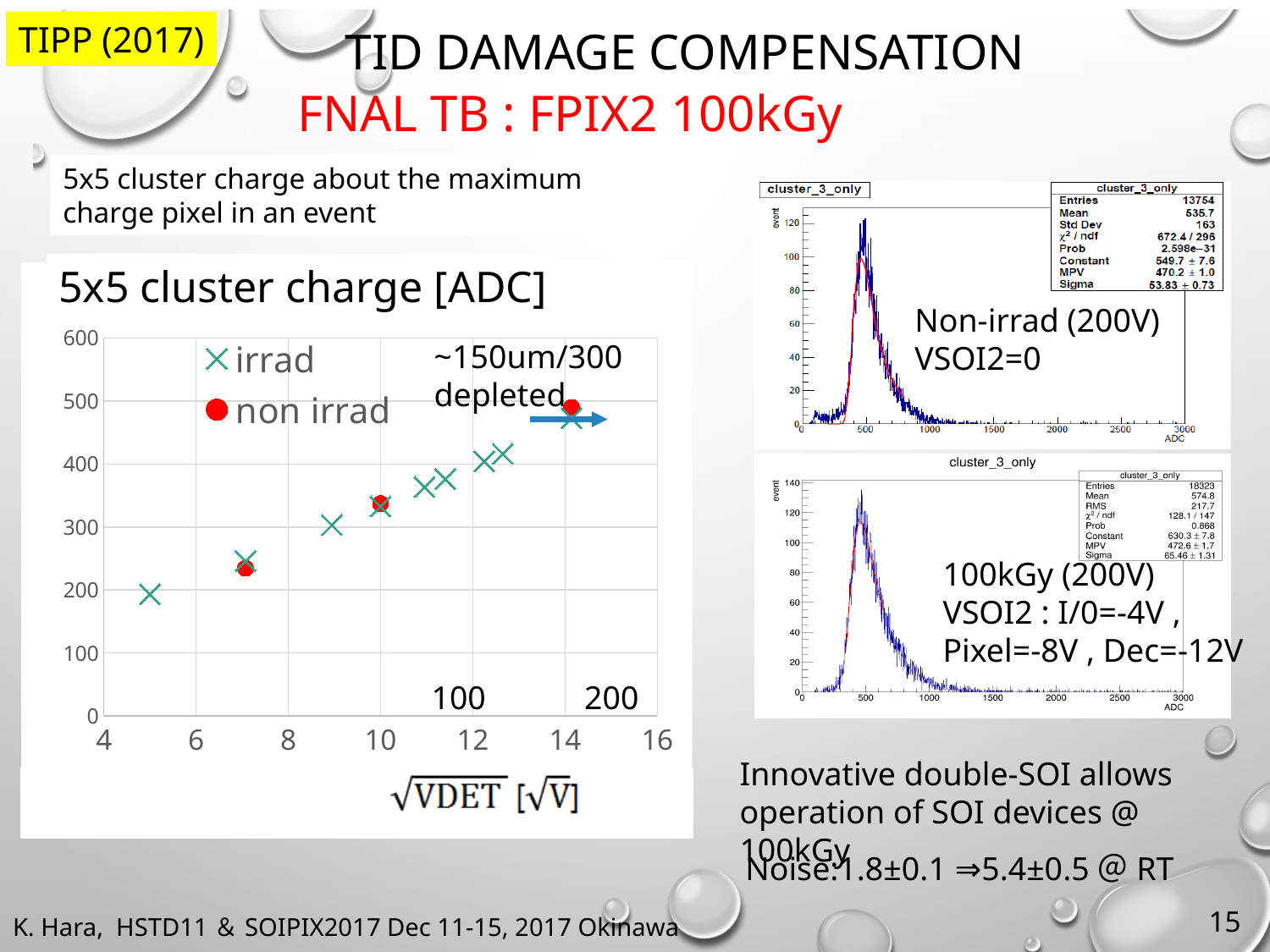
In the '5x5 cluster charge [ADC]' chart, how many non irrad (red dot) points are plotted? 3 In the '5x5 cluster charge [ADC]' chart, is the non irrad value at √VDET ≈ 10 greater or less than 300? greater How many series does the legend of the '5x5 cluster charge [ADC]' chart list? 2 What are the two series named in the legend of the '5x5 cluster charge [ADC]' chart? irrad and non irrad In the bottom-right histogram (100kGy, 200V), what is the Mean reported in the stat box? 574.8 What is the difference in entries between the bottom-right 100kGy histogram (18323) and the top-right Non-irrad histogram (13754)? 4569 In the '5x5 cluster charge [ADC]' chart, is the irrad value at √VDET ≈ 14 greater or less than 400? greater In the '5x5 cluster charge [ADC]' chart, is the irrad value at √VDET ≈ 9 greater or less than 400? less In the top-right histogram (Non-irrad, 200V), how many entries does the stat box report? 13754 Which histogram has more entries, the top-right Non-irrad one or the bottom-right 100kGy one? the bottom-right 100kGy histogram What kind of chart is the '5x5 cluster charge [ADC]' chart on the left? scatter chart In the '5x5 cluster charge [ADC]' chart, do the irrad values rise or fall as √VDET increases? rise